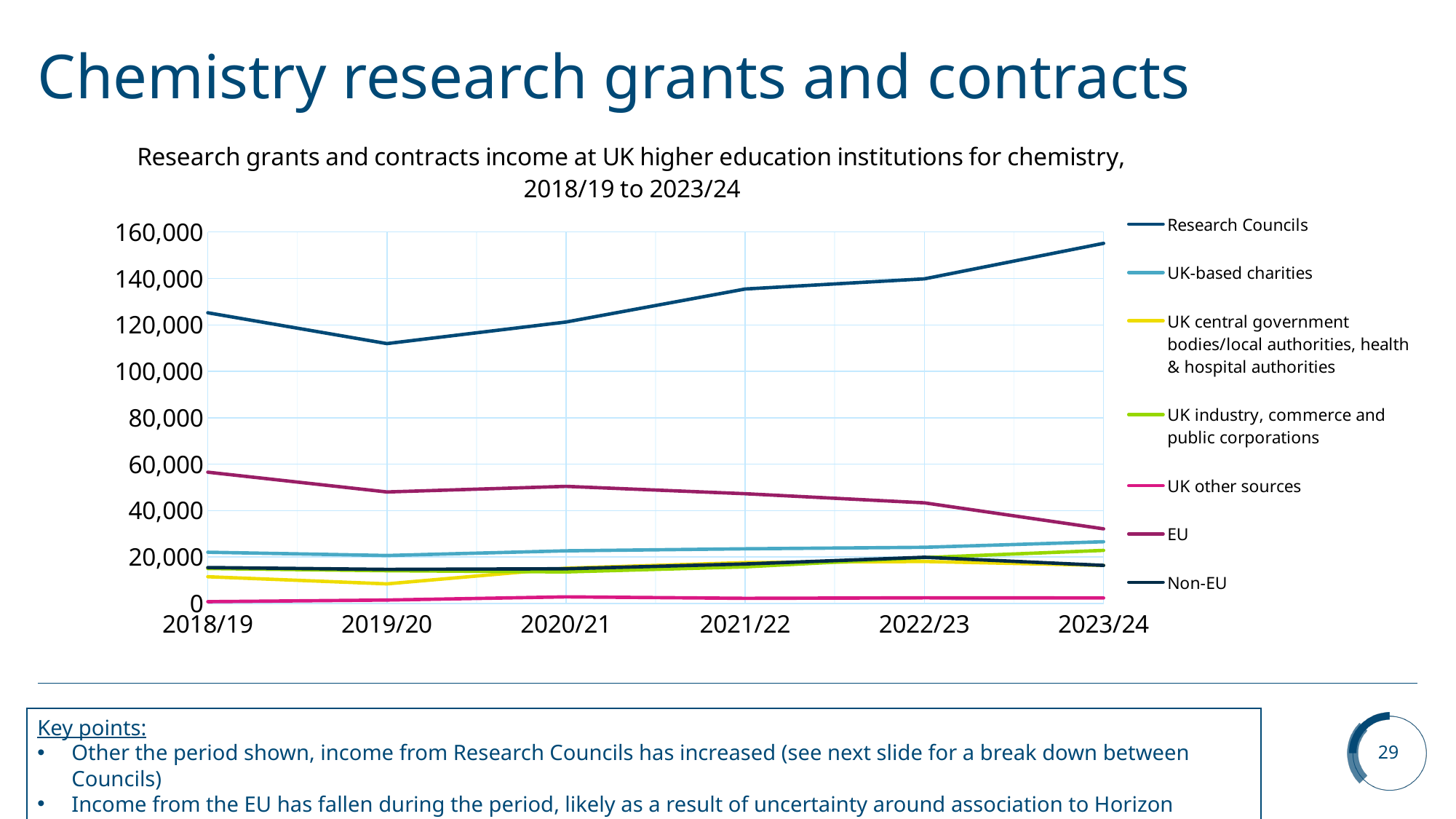
Does the EU line rise or fall from 2020/21 to 2023/24? fall Which series has the lowest value in 2018/19? UK other sources Is the value for Research Councils in 2019/20 greater or less than 120,000? less Does the Research Councils line rise or fall from 2019/20 to 2023/24? rise What kind of chart is shown on the slide? line chart Is the value for EU in 2018/19 greater or less than 40,000? greater What is the title of the chart? Research grants and contracts income at UK higher education institutions for chemistry, 2018/19 to 2023/24 How many academic years are shown on the x axis? 6 Which is larger in 2018/19, the value for EU or the value for UK-based charities? EU How many series does the legend list? 7 Is the value for Research Councils in 2023/24 greater or less than 140,000? greater Which series has the highest value in 2023/24? Research Councils